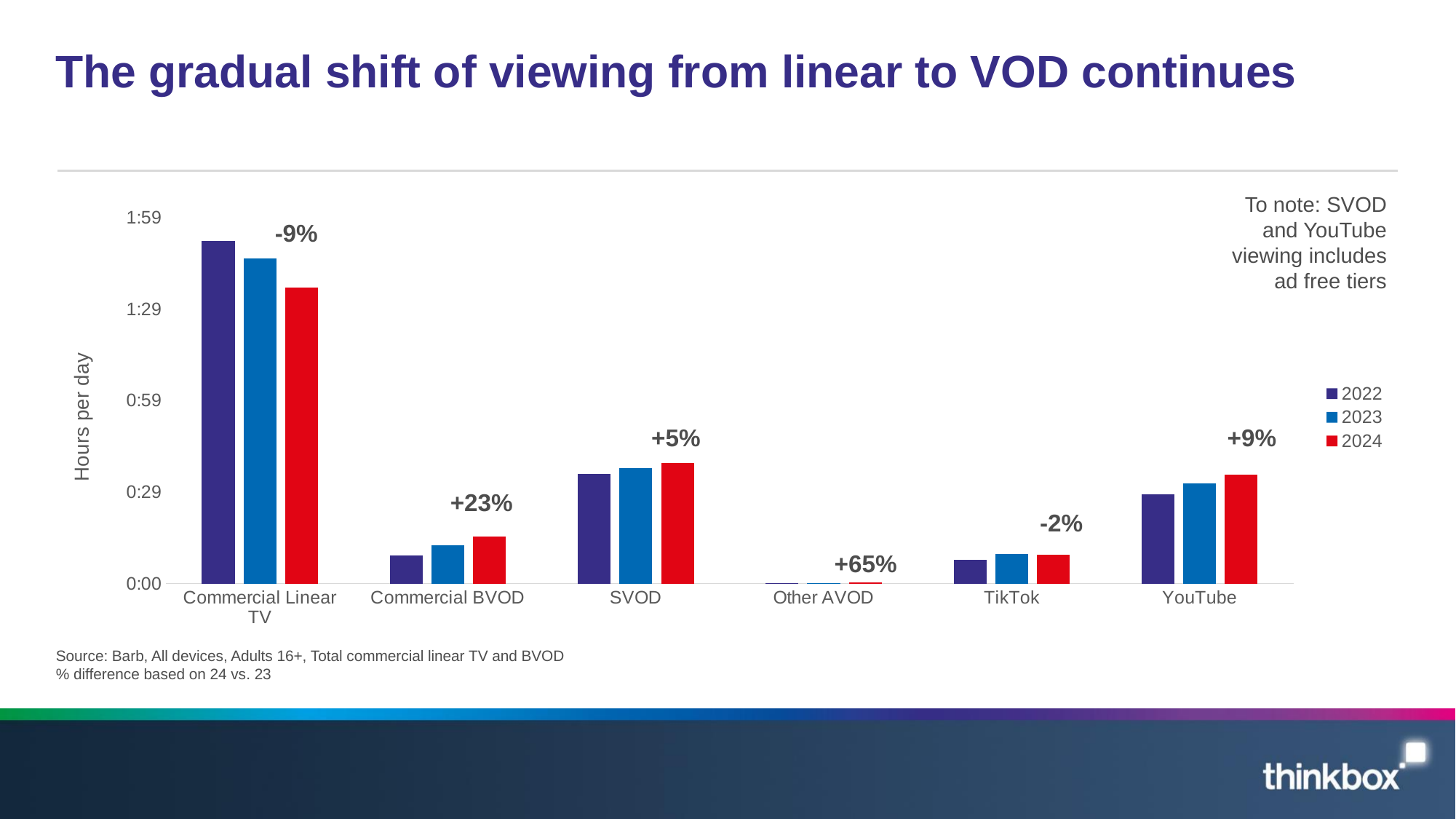
What percentage change is labelled for Commercial Linear TV? -9% How many categories are shown on the x axis? 6 Is the 2024 value for Commercial Linear TV greater or less than 1:29? greater Which category has the lowest hours per day in 2024? Other AVOD What percentage change is labelled for TikTok? -2% What percentage change is labelled for Commercial BVOD? +23% What kind of chart is shown on the slide? bar chart Which category has the highest hours per day in 2024? Commercial Linear TV Do the Commercial Linear TV bars rise or fall from 2022 to 2024? fall What percentage change is labelled for Other AVOD? +65% What is the label on the y axis? Hours per day How many series does the legend list? 3